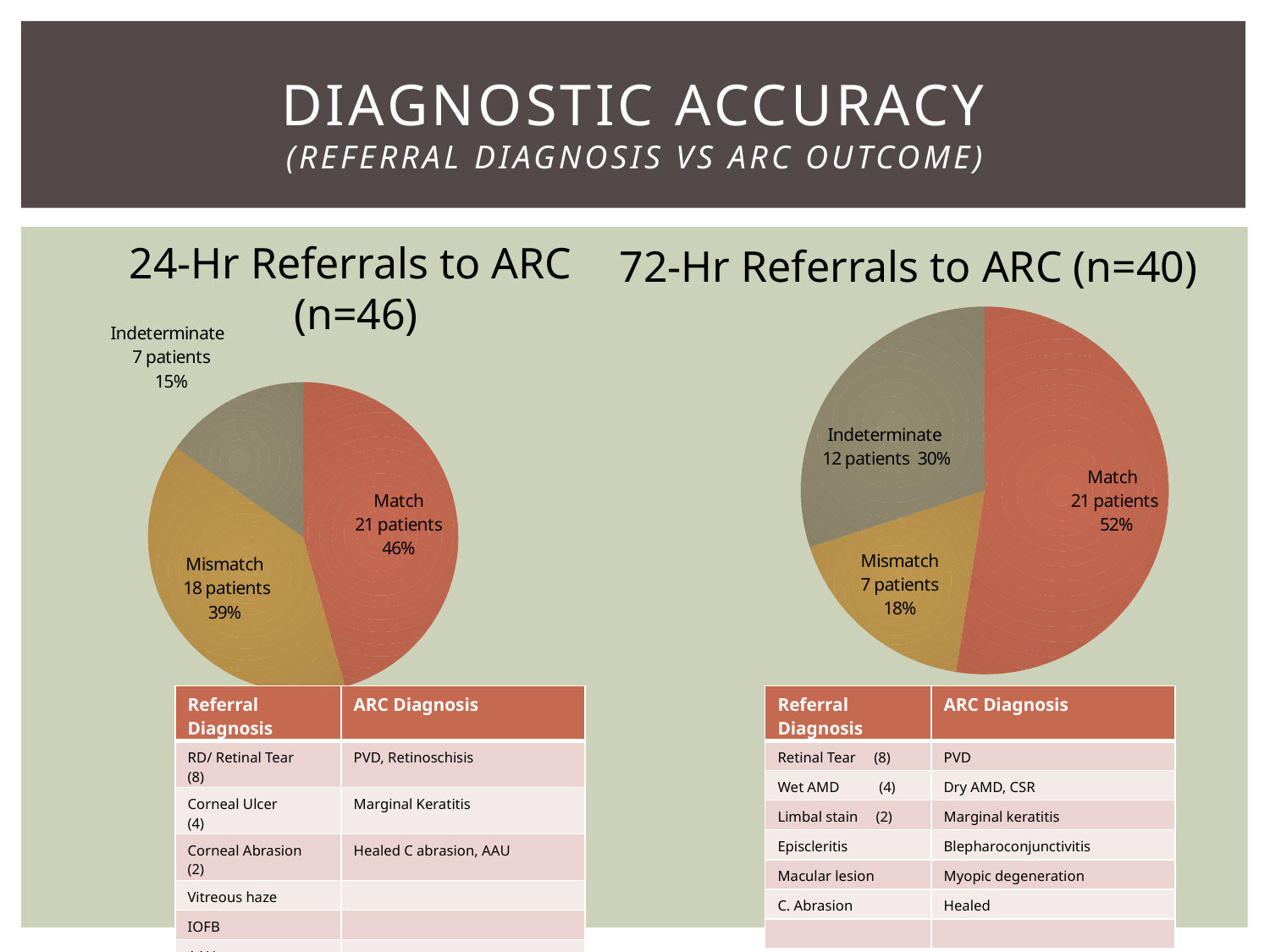
In the 72-Hr Referrals to ARC chart, what percentage share does the Match slice have? 52% In the 72-Hr Referrals to ARC chart, which is larger: Indeterminate or Mismatch? Indeterminate What type of chart is used for the 72-Hr Referrals to ARC data? Pie chart In the 72-Hr Referrals to ARC chart, what is the difference in patient count between Match and Mismatch? 14 patients In the 72-Hr Referrals to ARC chart, how many patients are Indeterminate? 12 patients In the 24-Hr Referrals to ARC chart, which category has the fewest patients? Indeterminate In the 24-Hr Referrals to ARC chart, how many patients are in the Match category? 21 patients In the 72-Hr Referrals to ARC chart, which category has the largest share? Match In the 24-Hr Referrals to ARC chart, what is the difference in patient count between Match and Mismatch? 3 patients In the 24-Hr Referrals to ARC chart, what percentage share does the Mismatch slice have? 39% What is the sample size (n) shown in the title of the 72-Hr Referrals to ARC chart? 40 How many slices does the 24-Hr Referrals to ARC pie chart have? 3